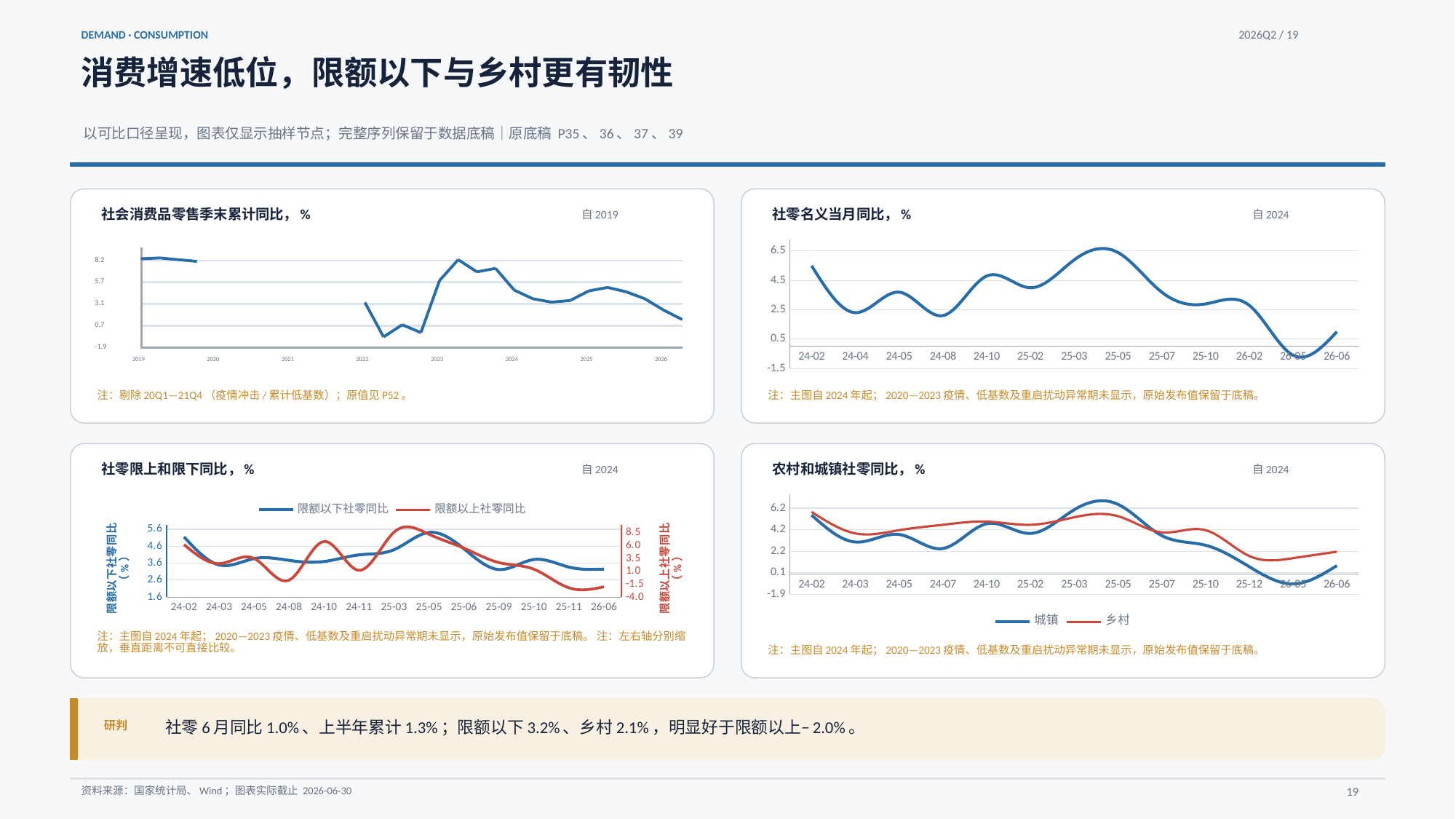
What kind of chart is the top-left chart titled 社会消费品零售季末累计同比，%? line chart In the bottom-right chart 农村和城镇社零同比，%, which series is higher at 25-05, 城镇 or 乡村? 城镇 How many x-axis labels are shown in the bottom-left chart 社零限上和限下同比，%? 13 In the bottom-right chart 农村和城镇社零同比，%, which series is higher at 26-06, 城镇 or 乡村? 乡村 In the top-left chart 社会消费品零售季末累计同比，%, does the line rise or fall from 2024 to 2026? fall In the bottom-right chart 农村和城镇社零同比，%, is the 城镇 value at 25-05 greater or less than 4.2? greater How many series does the legend list in the bottom-left chart 社零限上和限下同比，%? 2 In the top-right chart 社零名义当月同比，%, is the value at 26-05 greater or less than 0.5? less In the top-right chart 社零名义当月同比，%, is the value at 25-05 greater or less than 4.5? greater In the bottom-left chart 社零限上和限下同比，%, which series is drawn in red? 限额以上社零同比 In the top-right chart 社零名义当月同比，%, which x-axis label has the highest value? 25-05 In the top-right chart 社零名义当月同比，%, which x-axis label has the lowest value? 26-05